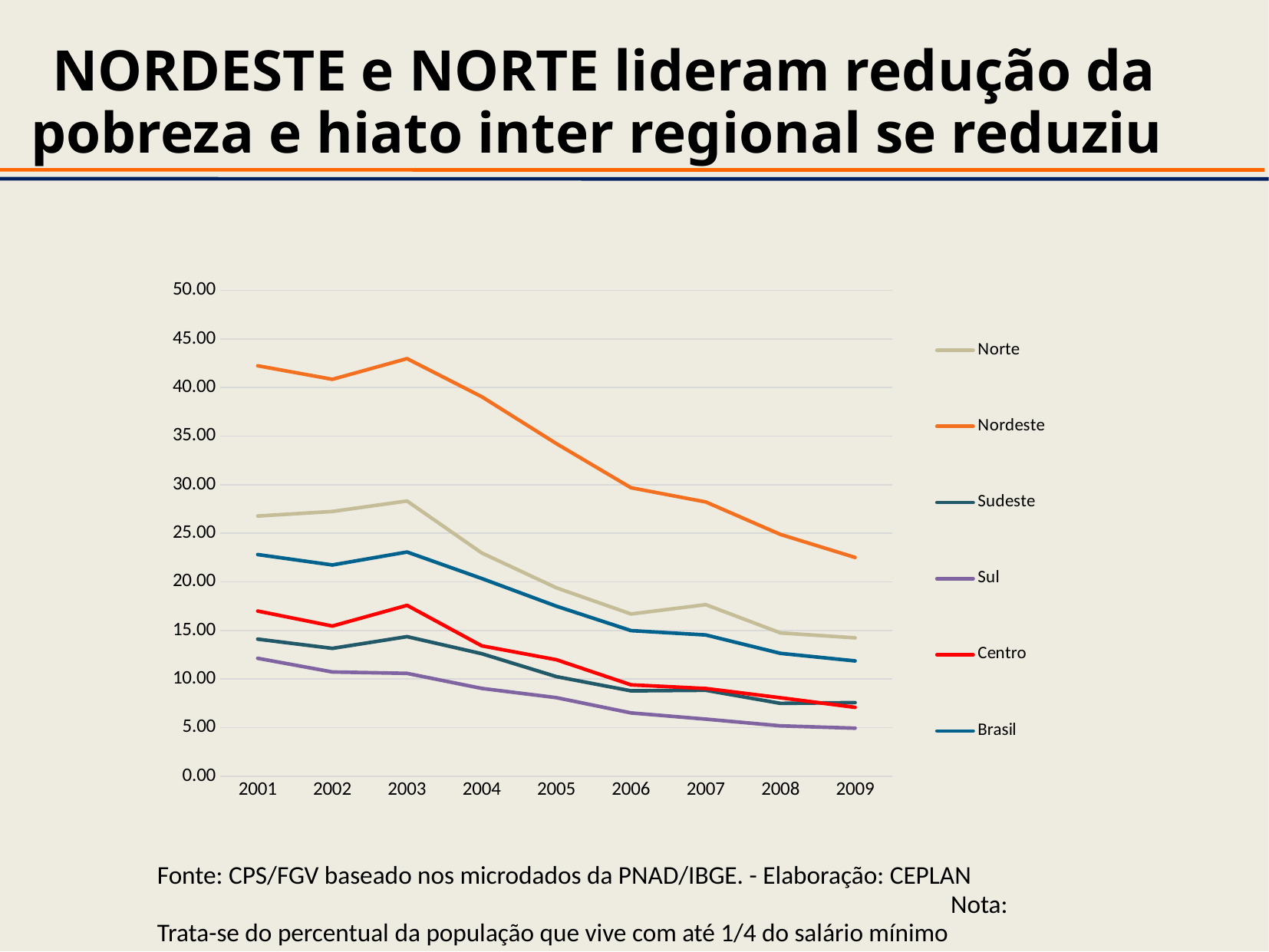
Is the value for Nordeste in 2009 greater or less than 25? less What kind of chart is shown on the slide? line chart Is the value for Brasil in 2001 greater or less than 20? greater In 2005, which is larger, the value for Nordeste or the value for Norte? Nordeste How many series does the legend list? 6 Which colour is used for the Nordeste line in the legend? orange Which series has the highest value in 2001? Nordeste Does the Nordeste line rise or fall from 2003 to 2009? fall Is the value for Nordeste in 2001 greater or less than 40? greater How many years are shown on the x axis? 9 Which series has the lowest value in 2009? Sul